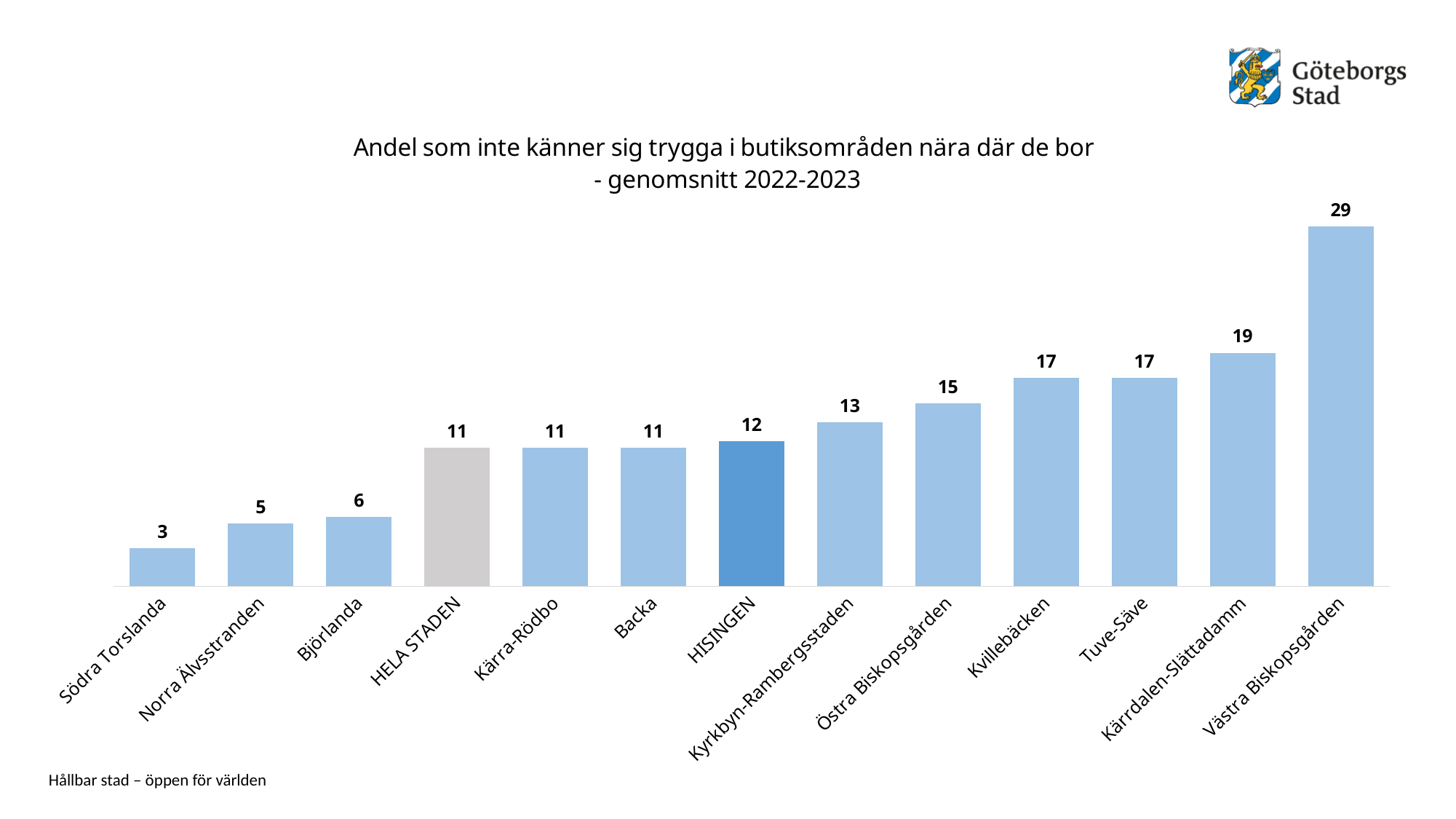
What is the difference between the values for Västra Biskopsgården and Kärrdalen-Slättadamm? 10 What is the difference between the values for HISINGEN and HELA STADEN? 1 What is the value for Kyrkbyn-Rambergsstaden? 13 Which category has the highest value? Västra Biskopsgården Which category has the lowest value? Södra Torslanda What is the value for HISINGEN? 12 What kind of chart is shown on the slide? Bar chart Which is larger, the value for Kvillebäcken or the value for Östra Biskopsgården? Kvillebäcken What is the value for Västra Biskopsgården? 29 Do the values rise or fall from left to right along the x axis? Rise How many categories are shown on the x axis? 13 What is the value for HELA STADEN? 11